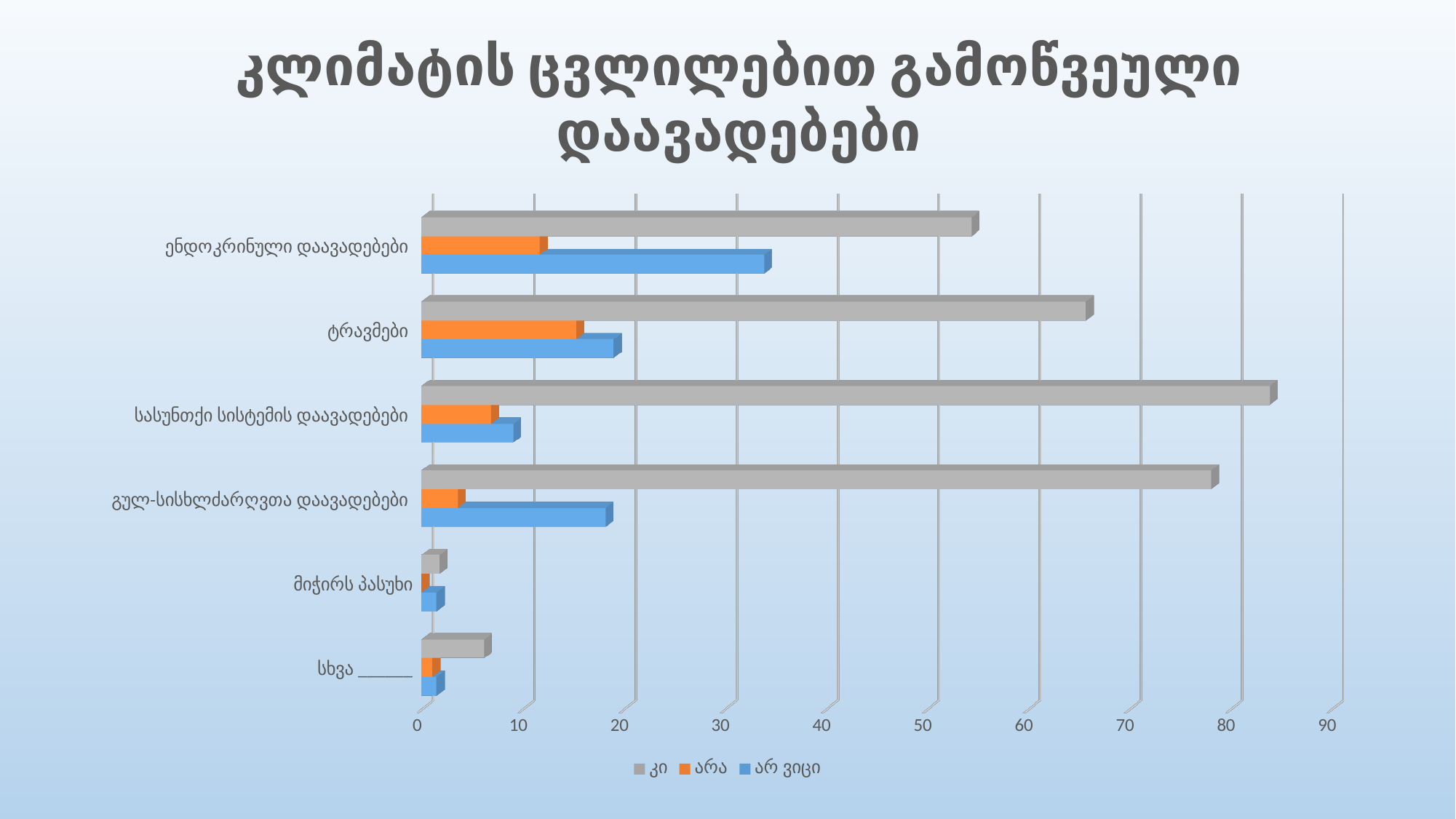
Is the არ ვიცი value for ენდოკრინული დაავადებები greater or less than 30? greater Which category has the lowest value for the კი series? მიჭირს პასუხი How many categories are shown on the chart? 6 Which is larger: the კი value for გულ-სისხლძარღვთა დაავადებები or the კი value for ტრავმები? გულ-სისხლძარღვთა დაავადებები Which category has the highest value for the არ ვიცი series? ენდოკრინული დაავადებები Is the კი value for ენდოკრინული დაავადებები greater or less than 60? less Which is larger for ტრავმები: the კი value or the არა value? კი Is the კი value for სასუნთქი სისტემის დაავადებები greater or less than 80? greater What kind of chart is shown on the slide? bar chart How many series does the legend list? 3 Which category has the highest value for the კი series? სასუნთქი სისტემის დაავადებები What are the three series listed in the legend? კი, არა, არ ვიცი